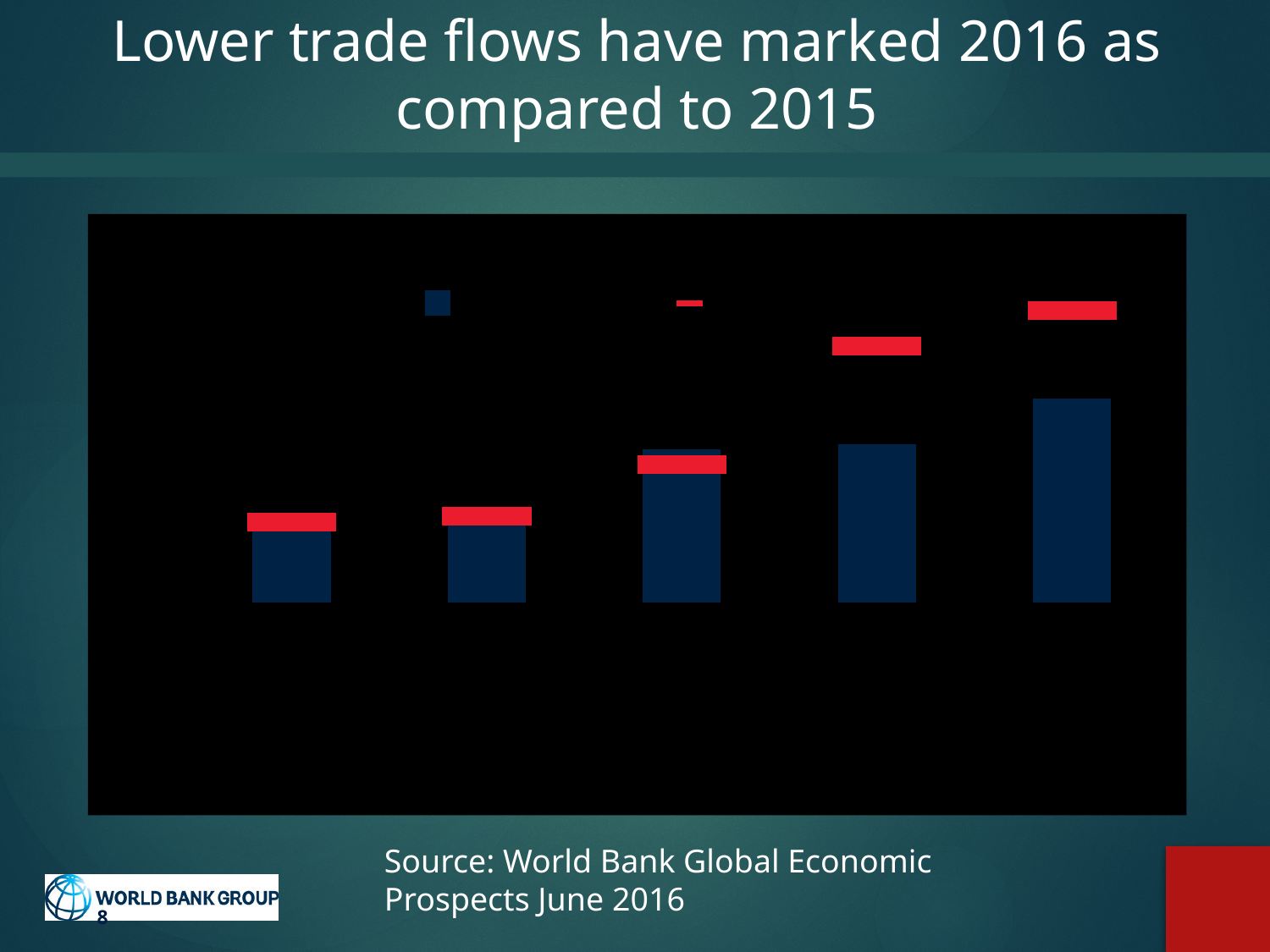
What kind of chart is shown on the slide? bar chart What two colours are used for the markers and bars in the chart? dark blue and red How many dark blue bars are plotted in the chart? 5 Which dark blue bar is the tallest: the leftmost or the rightmost? the rightmost Do the heights of the dark blue bars rise or fall from left to right across the chart? rise Is the leftmost dark blue bar taller or shorter than the middle dark blue bar? shorter What is the background colour of the chart area? black